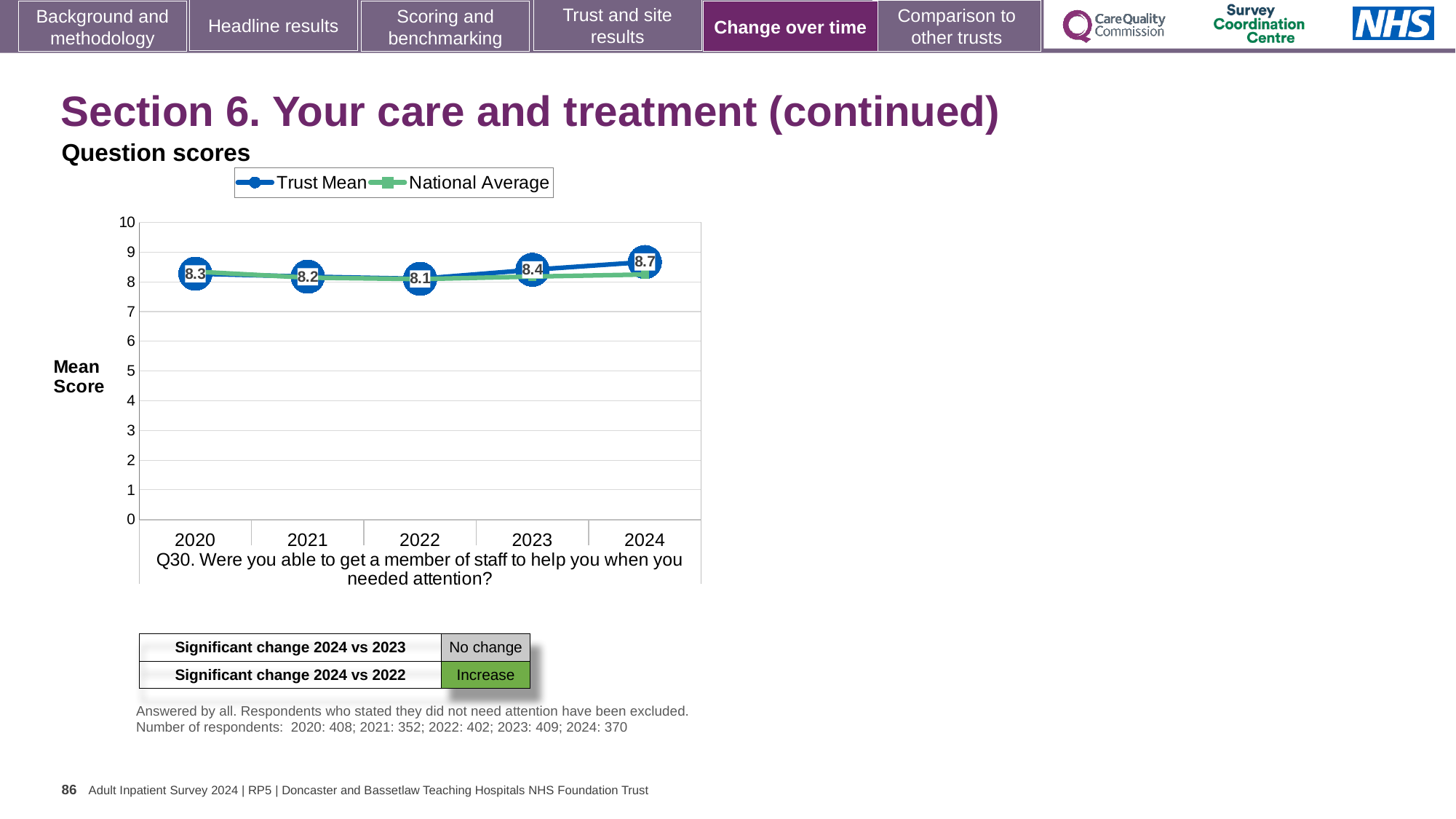
How many series does the legend list? 2 How many years are plotted on the x axis? 5 What is the difference between the Trust Mean scores for 2024 and 2022? 0.6 What is the Trust Mean score for 2022? 8.1 Is the Trust Mean score for 2024 greater or less than 8? greater Does the Trust Mean score rise or fall from 2022 to 2024? rise Which year has the highest Trust Mean score? 2024 What is the Trust Mean score for 2024? 8.7 What kind of chart is shown? line chart Which year has the lowest Trust Mean score? 2022 Which is larger, the Trust Mean score for 2023 or for 2021? 2023 What is the Trust Mean score for 2020? 8.3